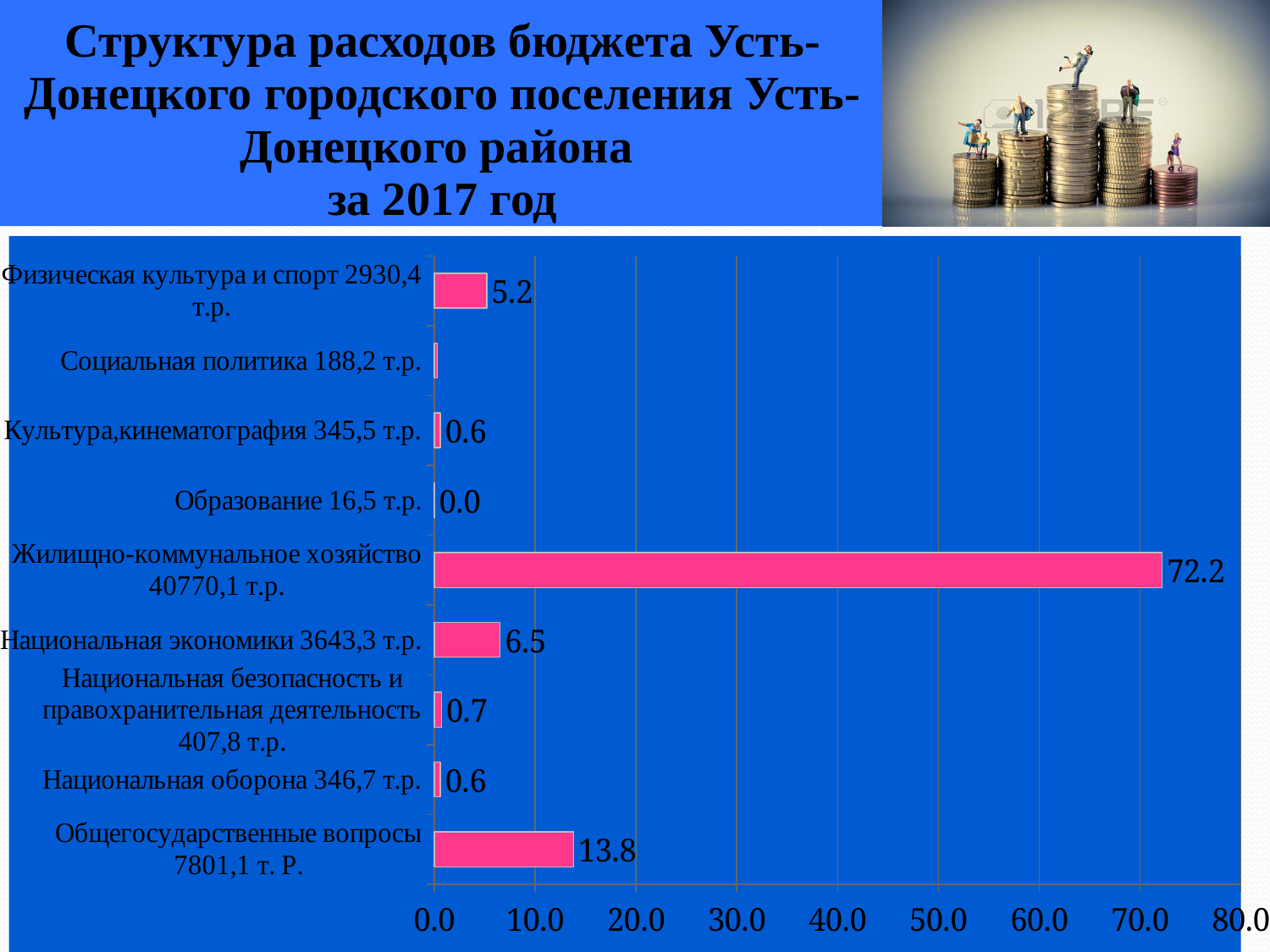
What is the value for Национальная экономики? 6.5 What is the value for Образование? 0.0 What is the value for Общегосударственные вопросы? 13.8 Which category has the lowest value? Образование How many categories are shown on the chart? 9 Which category has the highest value? Жилищно-коммунальное хозяйство Is the value for Жилищно-коммунальное хозяйство greater or less than 70.0? greater Which is larger, the value for Физическая культура и спорт or the value for Национальная экономики? Национальная экономики What is the value for Физическая культура и спорт? 5.2 What is the difference between the values for Общегосударственные вопросы and Национальная экономики? 7.3 What type of chart is shown on the slide? bar chart What is the value for Жилищно-коммунальное хозяйство? 72.2